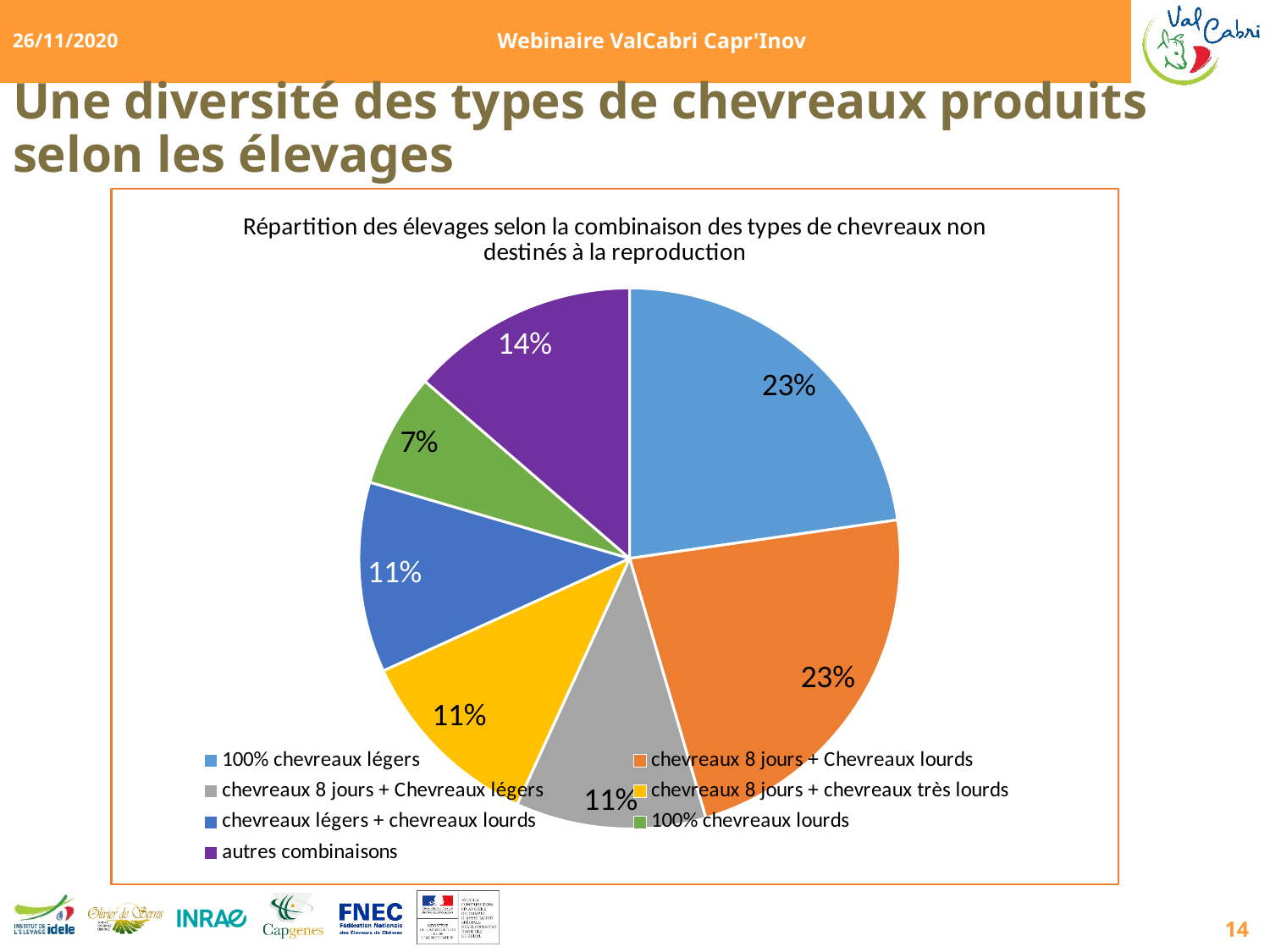
Which is larger: the slice for '100% chevreaux légers' or the slice for 'chevreaux 8 jours + Chevreaux légers'? 100% chevreaux légers What percentage is shown for 'chevreaux 8 jours + Chevreaux lourds'? 23% What is the title of the pie chart? Répartition des élevages selon la combinaison des types de chevreaux non destinés à la reproduction What percentage is shown for '100% chevreaux lourds'? 7% What kind of chart is shown on the slide? pie chart How many entries does the legend list? 7 Which category has the smallest slice of the pie? 100% chevreaux lourds What percentage is shown for 'autres combinaisons'? 14% What is the difference in percentage points between 'autres combinaisons' and '100% chevreaux lourds'? 7 percentage points How many slices does the pie chart have? 7 What percentage is shown for 'chevreaux légers + chevreaux lourds'? 11% What share of the pie is labelled for '100% chevreaux légers'? 23%